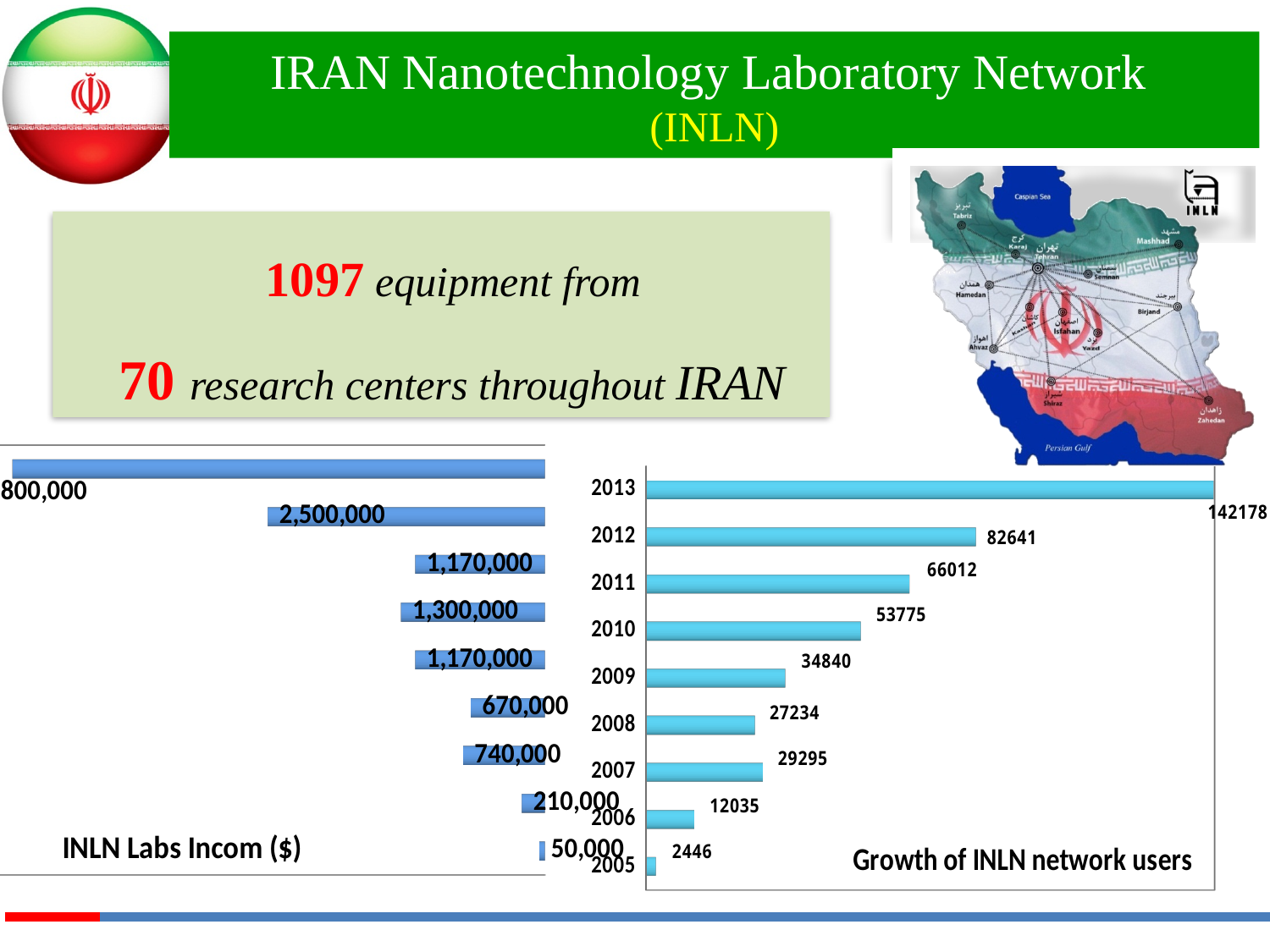
What type of chart is the 'Growth of INLN network users' chart? bar chart In the 'Growth of INLN network users' chart, what is the value for 2013? 142178 In the 'Growth of INLN network users' chart, what is the value for 2010? 53775 In the 'Growth of INLN network users' chart, do the values generally rise or fall from 2005 to 2013? rise In the 'Growth of INLN network users' chart, which is larger, the value for 2007 or the value for 2008? 2007 In the 'INLN Labs Incom ($)' chart, what is the smallest value shown? 50,000 In the 'Growth of INLN network users' chart, which year has the lowest number of users? 2005 How many bars are shown in the 'INLN Labs Incom ($)' chart? 9 How many years are shown in the 'Growth of INLN network users' chart? 9 In the 'Growth of INLN network users' chart, which year has the highest number of users? 2013 In the 'Growth of INLN network users' chart, what is the difference between the values for 2013 and 2012? 59537 In the 'Growth of INLN network users' chart, what is the value for 2005? 2446